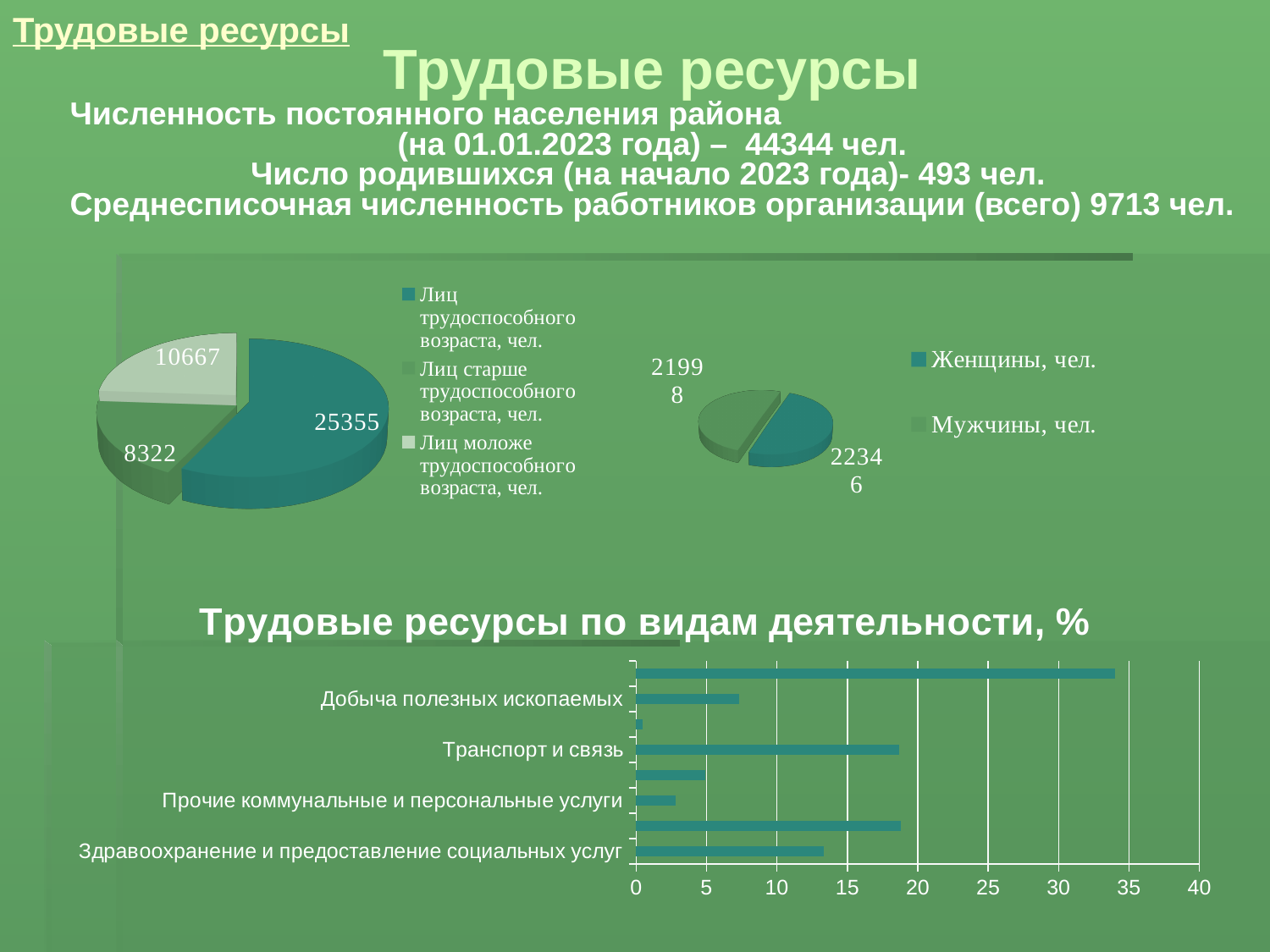
How many entries does the legend of the left pie chart list? 3 In the chart 'Трудовые ресурсы по видам деятельности, %', is the value for 'Прочие коммунальные и персональные услуги' greater or less than 5? less In the chart 'Трудовые ресурсы по видам деятельности, %', how many bars are plotted? 8 In the left pie chart, what is the difference between the values for 'Лиц старше трудоспособного возраста' and 'Лиц моложе трудоспособного возраста'? 2345 In the left pie chart, what is the value for 'Лиц старше трудоспособного возраста, чел.'? 10667 In the left pie chart, what is the value for 'Лиц моложе трудоспособного возраста, чел.'? 8322 In the right pie chart, what is the value for 'Мужчины, чел.'? 21998 In the chart 'Трудовые ресурсы по видам деятельности, %', is the value for 'Транспорт и связь' greater or less than 15? greater In the right pie chart, which is larger, the value for 'Женщины, чел.' or 'Мужчины, чел.'? Женщины, чел. In the left pie chart, what is the value for 'Лиц трудоспособного возраста, чел.'? 25355 What kind of chart is 'Трудовые ресурсы по видам деятельности, %'? bar chart In the left pie chart, which category has the largest slice? Лиц трудоспособного возраста, чел.